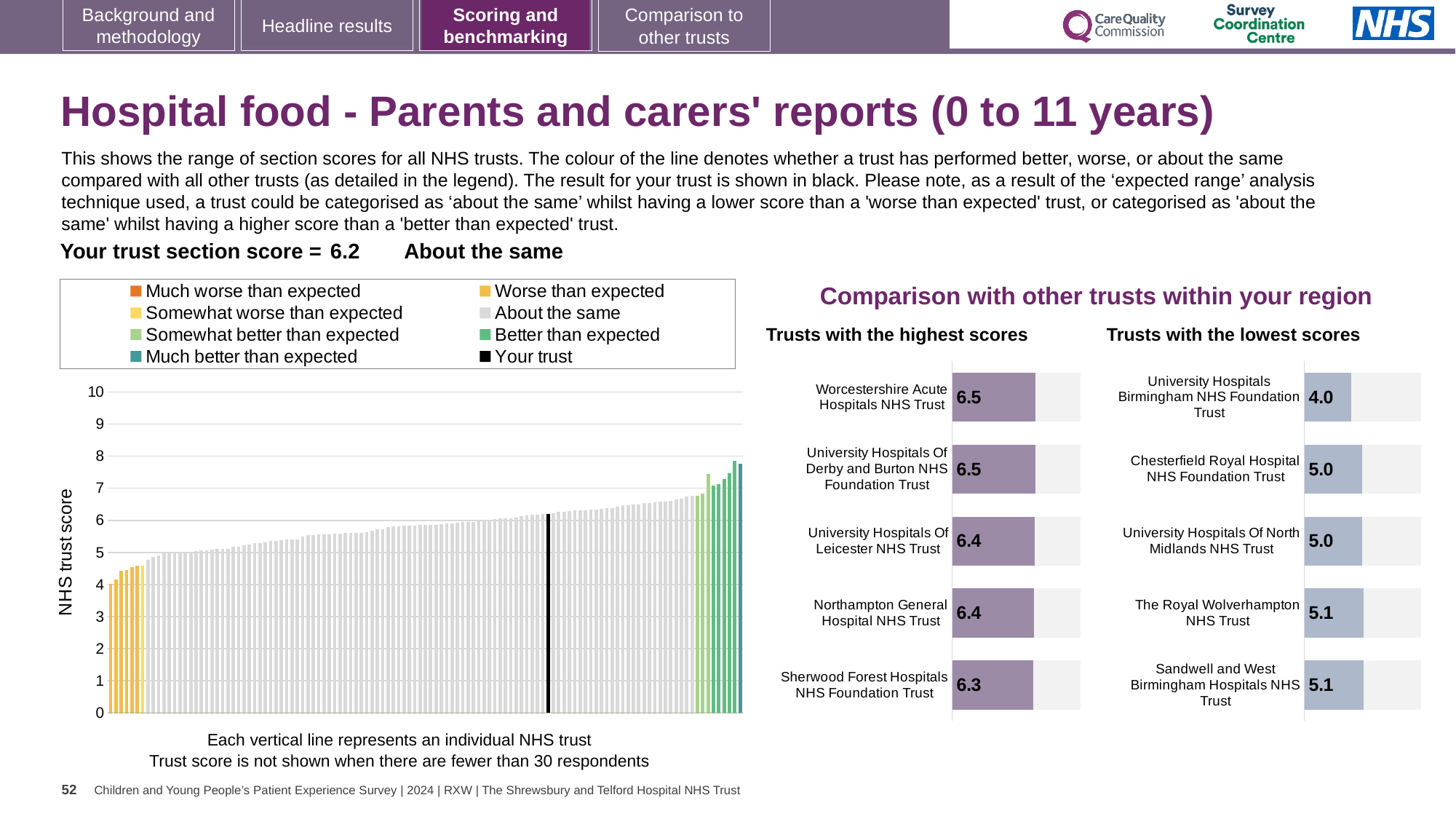
In the 'Trusts with the lowest scores' chart, which trust has the lowest score? University Hospitals Birmingham NHS Foundation Trust In the main 'NHS trust score' chart, do the trust scores rise or fall from left to right? rise In the 'Trusts with the highest scores' chart, what is the score for Worcestershire Acute Hospitals NHS Trust? 6.5 In the main 'NHS trust score' chart, is the value of the leftmost (lowest) bar greater or less than 5? less What kind of chart is the main 'NHS trust score' chart on the left? bar chart In the main 'NHS trust score' chart, what is the section score for your trust (the black line)? 6.2 In the 'Trusts with the lowest scores' chart, what is the difference between the scores of Chesterfield Royal Hospital NHS Foundation Trust and University Hospitals Birmingham NHS Foundation Trust? 1.0 In the 'Trusts with the highest scores' chart, how many trusts are shown? 5 In the 'Trusts with the lowest scores' chart, which has the larger score: The Royal Wolverhampton NHS Trust or University Hospitals Birmingham NHS Foundation Trust? The Royal Wolverhampton NHS Trust In the 'Trusts with the highest scores' chart, which trust has the lowest score? Sherwood Forest Hospitals NHS Foundation Trust How many entries does the legend above the main 'NHS trust score' chart list? 8 In the main 'NHS trust score' chart, is the value of the rightmost (highest) bar greater or less than 7? greater